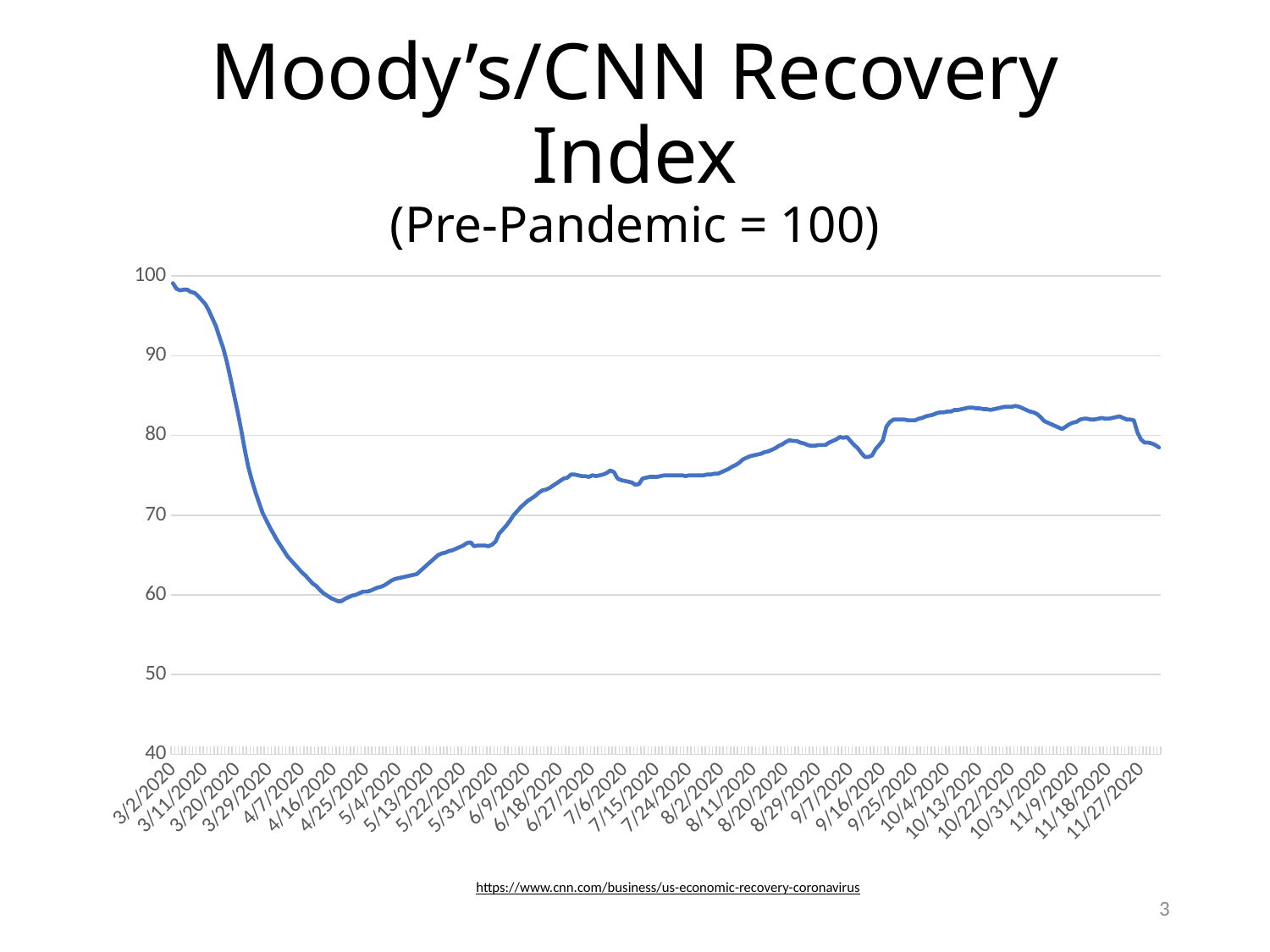
Does the index rise or fall between 3/2/2020 and 4/16/2020? fall Which date has the higher value, 3/2/2020 or 11/27/2020? 3/2/2020 Which date has the higher value, 4/25/2020 or 10/13/2020? 10/13/2020 What is the title of the chart? Moody's/CNN Recovery Index (Pre-Pandemic = 100) Does the index rise or fall between 4/25/2020 and 10/13/2020? rise What kind of chart is shown on the slide? line chart Is the value on 10/13/2020 greater or less than 80? greater Is the value on 6/27/2020 greater or less than 80? less Is the value on 3/2/2020 greater or less than 90? greater What is the highest value shown on the vertical axis? 100